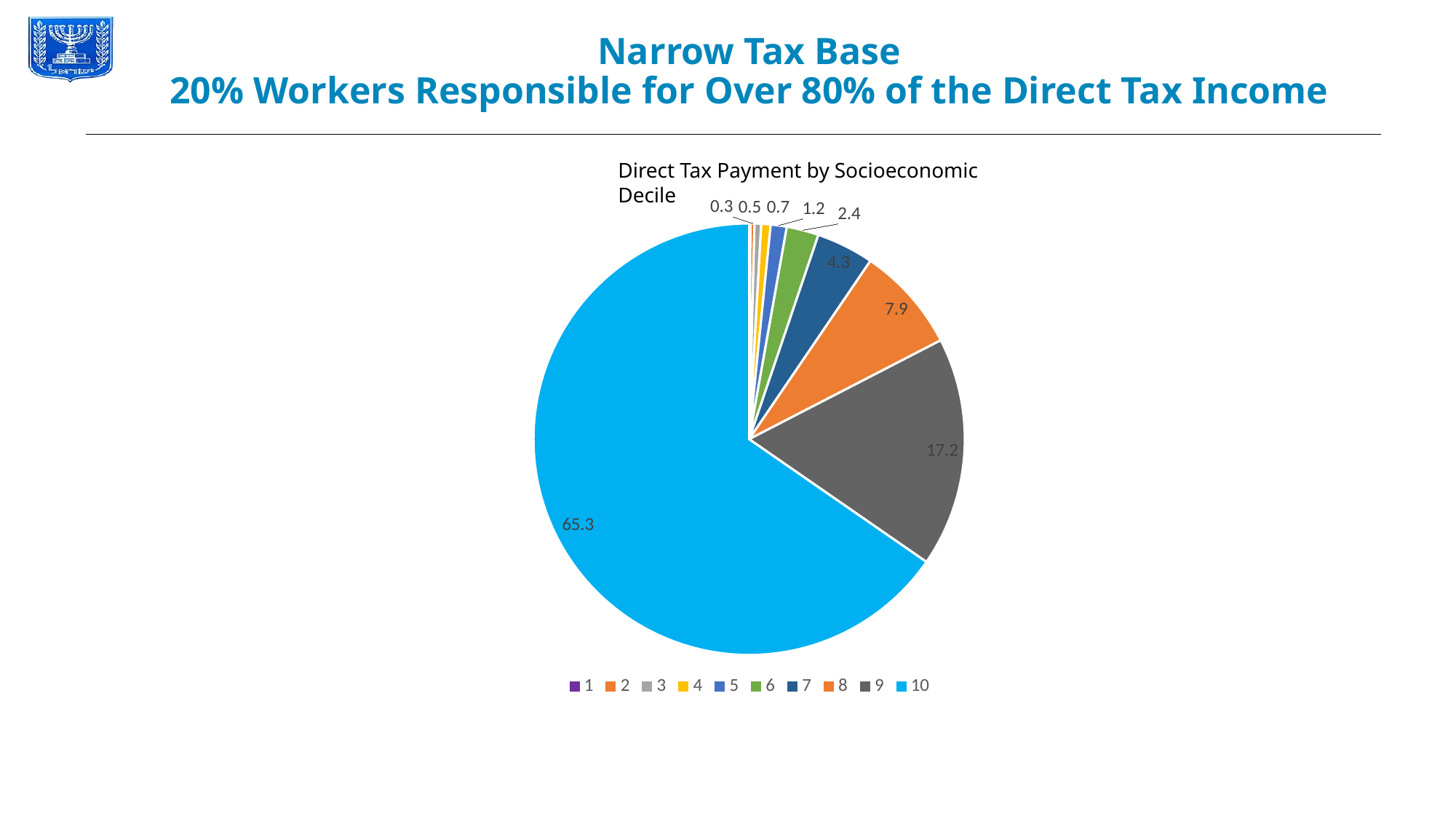
What is the value shown for decile 9 (the dark grey slice)? 17.2 What is the smallest value labelled on the pie chart? 0.3 What is the title of the chart? Direct Tax Payment by Socioeconomic Decile What is the value shown for decile 10 (the light blue slice)? 65.3 Which is larger, the value for decile 8 or the value for decile 7? Decile 8 What is the value shown for decile 8 (the orange slice)? 7.9 How many entries does the chart legend list? 10 What is the difference between the values for decile 10 and decile 9? 48.1 What is the value shown for decile 7 (the dark blue slice)? 4.3 Which decile has the largest share of direct tax payment? 10 What is the combined value of deciles 9 and 10? 82.5 What type of chart is shown on the slide? Pie chart